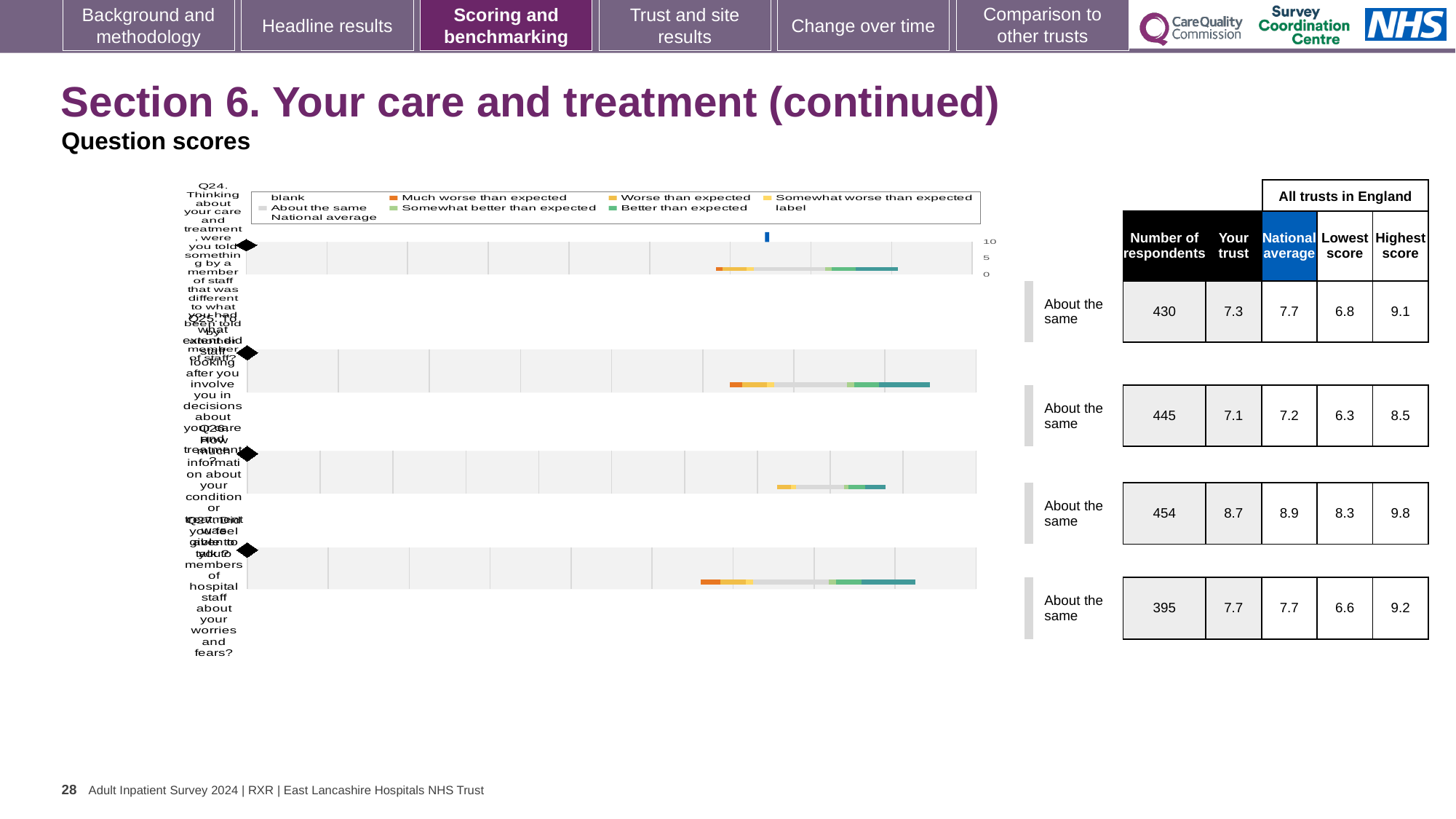
What is the highest score for the fourth row (Q27)? 9.2 How many question rows (bars) does the chart show? 4 What is the 'Your trust' score for the first row (Q24)? 7.3 Which row has the highest 'Your trust' score? Q26 Is the 'Your trust' score for Q24 larger or smaller than the national average for Q24? smaller Which row has the lowest number of respondents? Q27 What kind of chart is shown on the slide? bar chart What is the national average for the second row (Q25)? 7.2 What is the title of the slide containing the chart? Section 6. Your care and treatment (continued) What benchmark category is shown for Q25? About the same What is the number of respondents for the third row (Q26)? 454 What is the difference between the national average and the trust score for Q26? 0.2